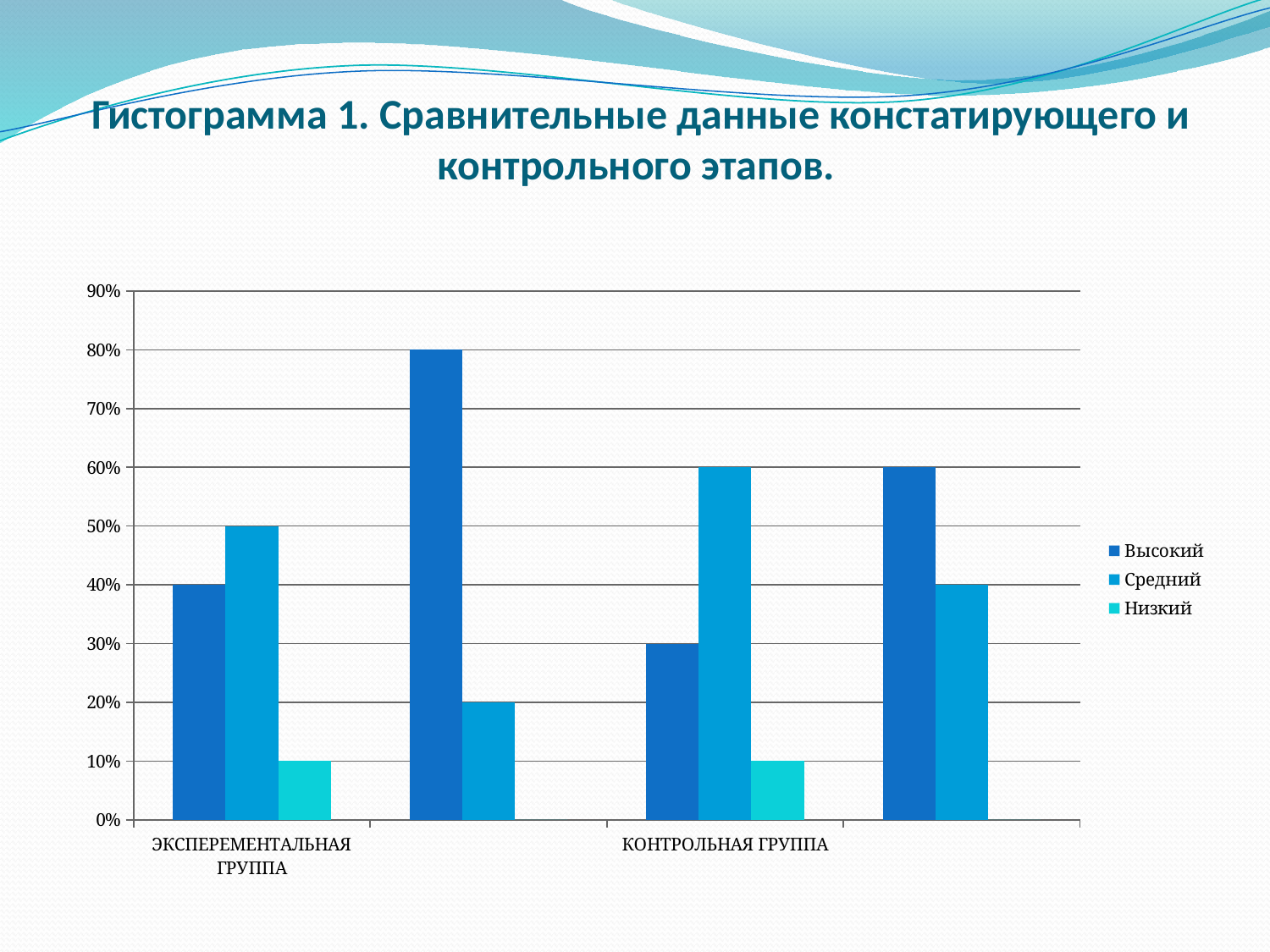
For ЭКСПЕРЕМЕНТАЛЬНАЯ ГРУППА, which series has the highest value? Средний How many series does the legend list? 3 What is the value of the Высокий series for ЭКСПЕРЕМЕНТАЛЬНАЯ ГРУППА? 40% What is the value of the Низкий series for ЭКСПЕРЕМЕНТАЛЬНАЯ ГРУППА? 10% What is the value of the Низкий series for КОНТРОЛЬНАЯ ГРУППА? 10% What kind of chart is shown on the slide? Bar chart What is the value of the Средний series for ЭКСПЕРЕМЕНТАЛЬНАЯ ГРУППА? 50% For КОНТРОЛЬНАЯ ГРУППА, what is the difference between the Средний value and the Высокий value? 30% What is the value of the Высокий series for КОНТРОЛЬНАЯ ГРУППА? 30% What is the value of the Средний series for КОНТРОЛЬНАЯ ГРУППА? 60% For КОНТРОЛЬНАЯ ГРУППА, which is larger: the Высокий value or the Средний value? Средний Which series is shown in the lightest (turquoise) colour in the legend? Низкий